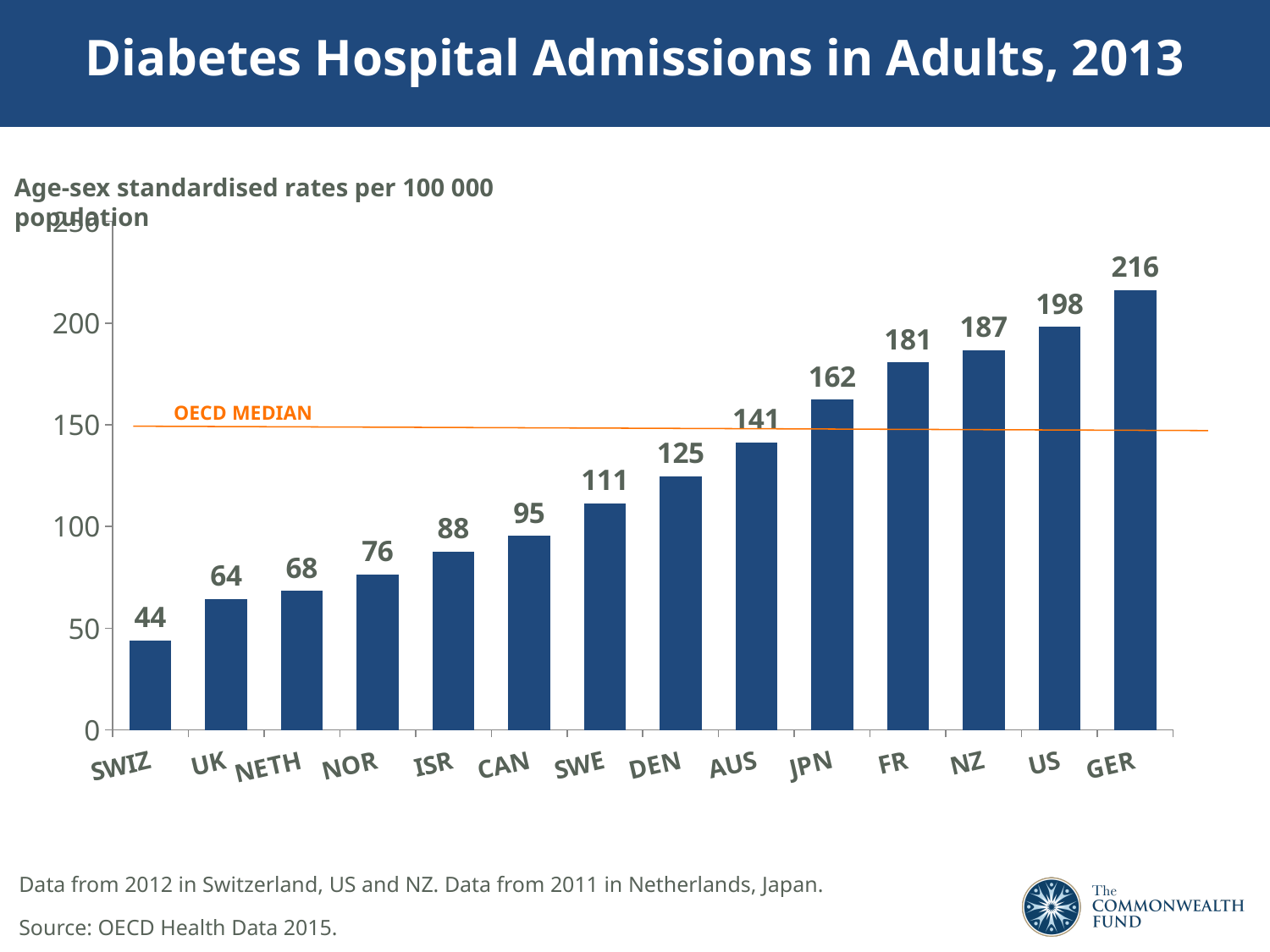
Which country has the highest diabetes hospital admission rate? GER What is the value shown for Switzerland (SWIZ)? 44 What is the value shown for the US? 198 What is the difference between the values for GER and SWIZ? 172 What is the diabetes hospital admission rate for Germany (GER)? 216 Which has a higher value, JPN or AUS? JPN What is the difference between the values for US and UK? 134 What does the orange horizontal line on the chart represent? OECD MEDIAN Is the value for DEN greater or less than 150? less How many countries are shown on the chart? 14 Which country has the lowest diabetes hospital admission rate? SWIZ What kind of chart is shown on the slide? bar chart